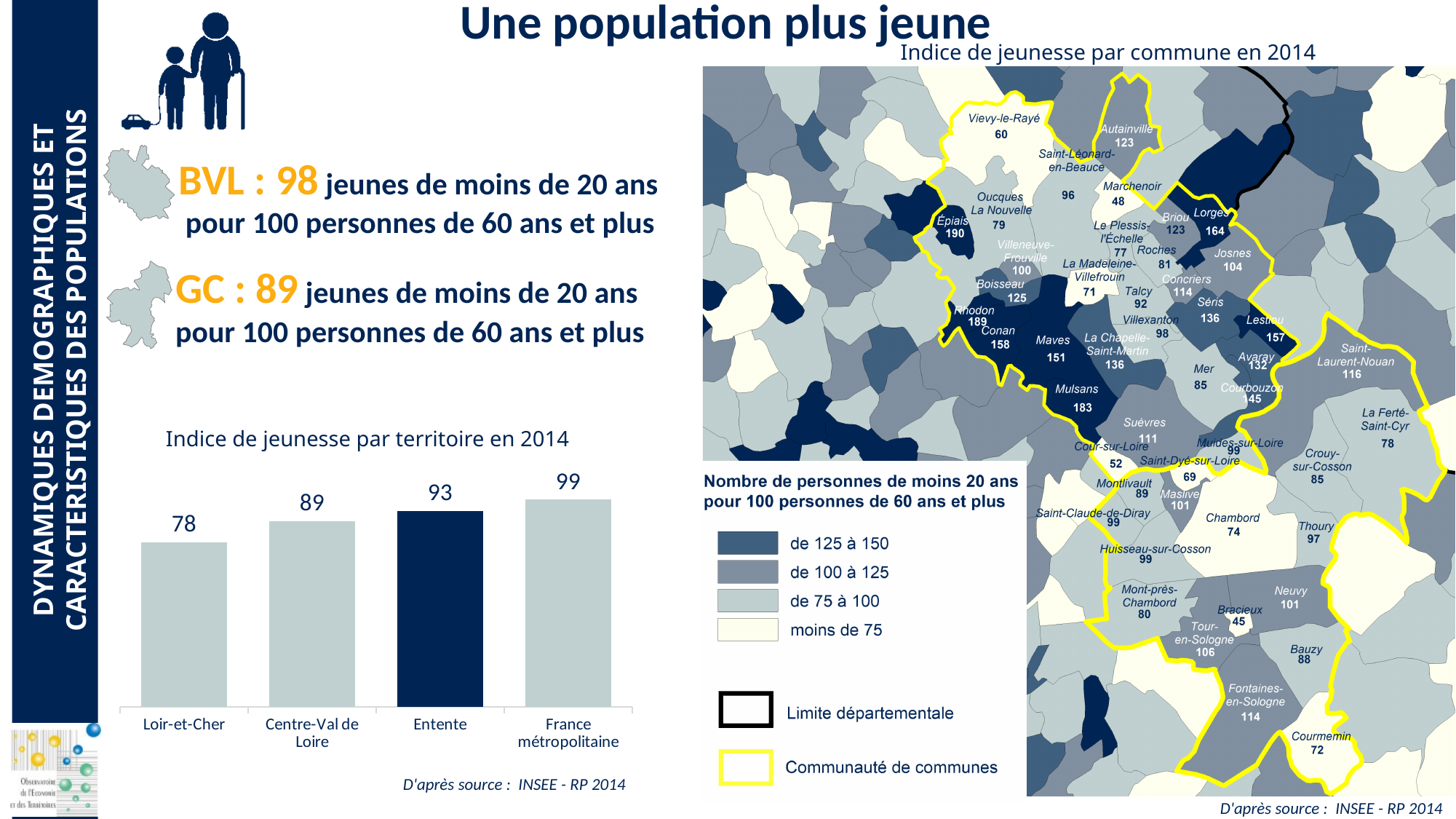
In the chart 'Indice de jeunesse par territoire en 2014', which territory has the highest value? France métropolitaine In the chart 'Indice de jeunesse par territoire en 2014', what is the value for Loir-et-Cher? 78 In the chart 'Indice de jeunesse par territoire en 2014', which is larger, Entente or Centre-Val de Loire? Entente In the chart 'Indice de jeunesse par territoire en 2014', what is the difference between France métropolitaine and Loir-et-Cher? 21 In the chart 'Indice de jeunesse par territoire en 2014', what is the value for Entente? 93 In the chart 'Indice de jeunesse par territoire en 2014', do the values rise or fall from left to right? Rise How many territories are shown in the chart 'Indice de jeunesse par territoire en 2014'? 4 In the chart 'Indice de jeunesse par territoire en 2014', what is the difference between Entente and Centre-Val de Loire? 4 In the chart 'Indice de jeunesse par territoire en 2014', what is the value for Centre-Val de Loire? 89 What kind of chart is 'Indice de jeunesse par territoire en 2014'? Bar chart In the chart 'Indice de jeunesse par territoire en 2014', what is the value for France métropolitaine? 99 In the chart 'Indice de jeunesse par territoire en 2014', which territory has the lowest value? Loir-et-Cher